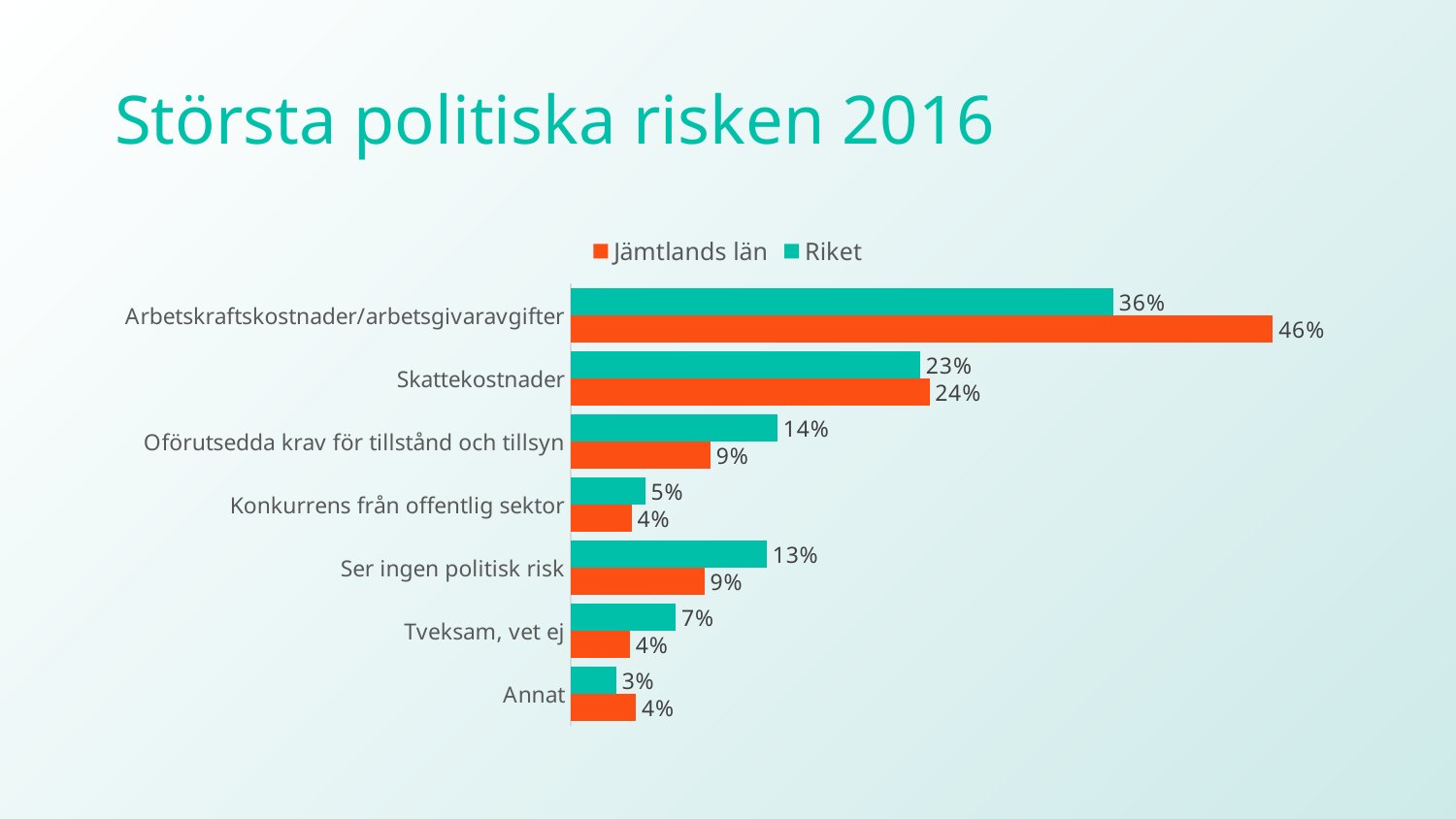
How many series does the legend list? 2 What is the title of the slide? Största politiska risken 2016 What is the value for Riket for Ser ingen politisk risk? 13% Which category has the lowest value for Riket? Annat What is the value for Jämtlands län for Arbetskraftskostnader/arbetsgivaravgifter? 46% What kind of chart is shown on the slide? Bar chart What is the value for Riket for Oförutsedda krav för tillstånd och tillsyn? 14% What is the difference between Jämtlands län and Riket for Arbetskraftskostnader/arbetsgivaravgifter? 10% Which is larger for Tveksam, vet ej: Jämtlands län or Riket? Riket What is the difference between Riket and Jämtlands län for Oförutsedda krav för tillstånd och tillsyn? 5% How many categories are shown in the chart? 7 Which category has the highest value for Riket? Arbetskraftskostnader/arbetsgivaravgifter